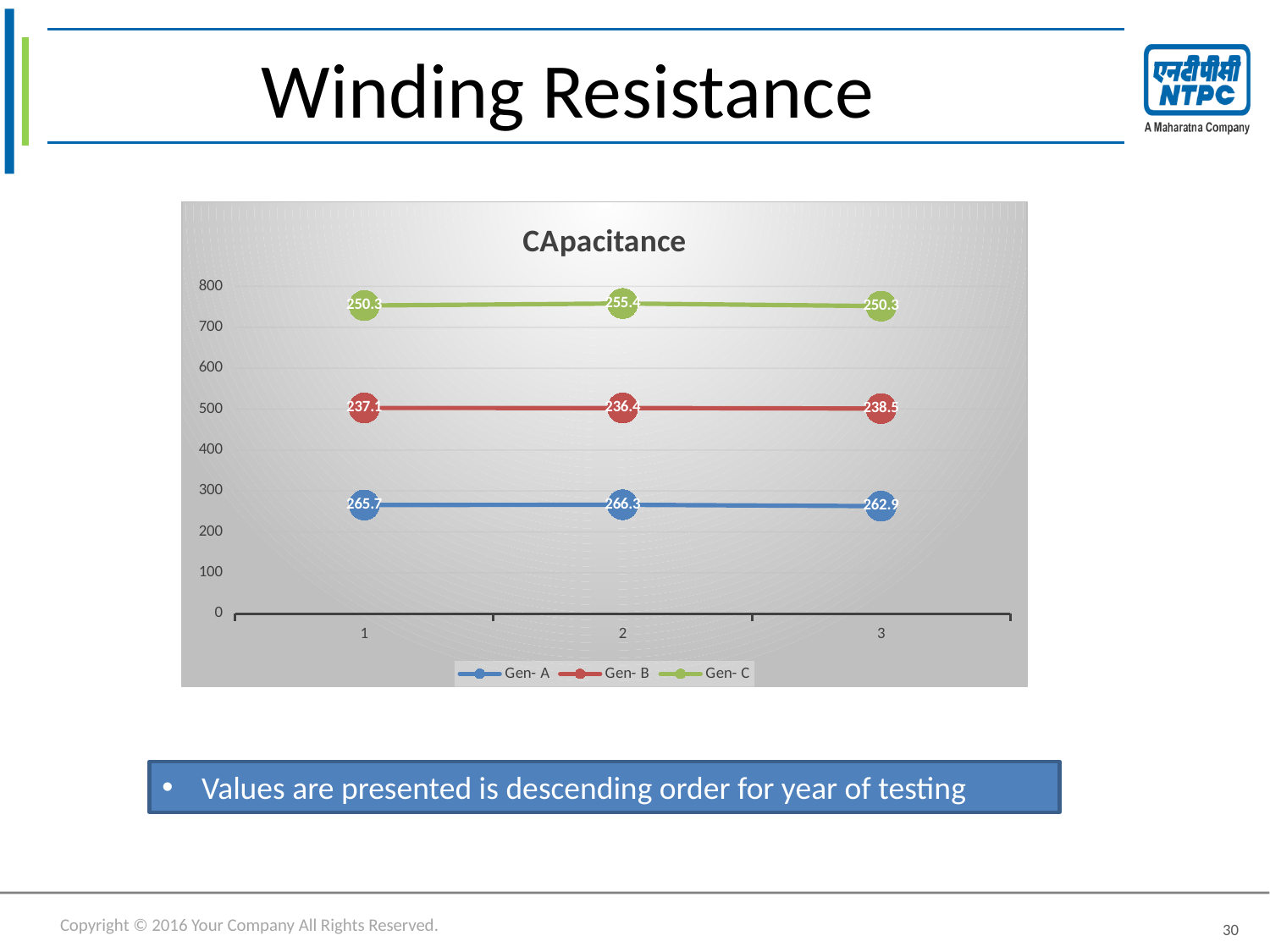
Which is larger, the Gen- B value at x = 1 or at x = 3? x = 3 What is the value for Gen- C at x = 2? 255.4 What kind of chart is shown? line chart What is the value for Gen- B at x = 3? 238.5 At which x value is Gen- A highest? 2 What is the value for Gen- A at x = 3? 262.9 What is the value for Gen- A at x = 1? 265.7 What is the difference between the Gen- A values at x = 1 and x = 3? 2.8 What is the difference between the Gen- C values at x = 2 and x = 1? 5.1 What is the title of the chart? CApacitance At which x value is Gen- B lowest? 2 How many series does the legend list? 3